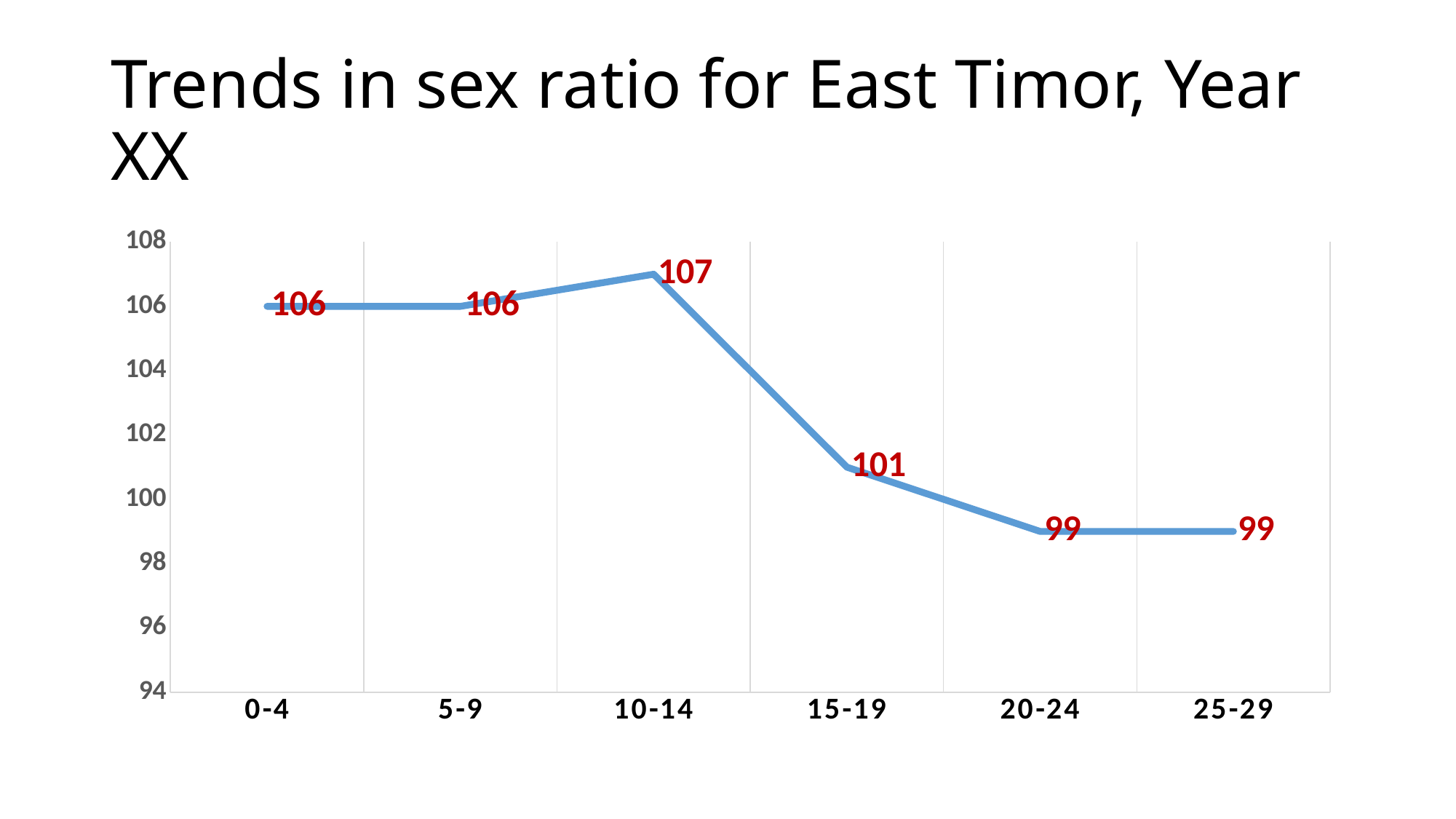
How many age groups are plotted on the chart? 6 Which is larger, the sex ratio for 5-9 or the sex ratio for 15-19? 5-9 What is the sex ratio for the 0-4 age group? 106 What is the difference between the sex ratio for 5-9 and the sex ratio for 15-19? 5 What is the sex ratio for the 10-14 age group? 107 Does the sex ratio rise or fall from the 10-14 age group to the 25-29 age group? fall Which age group has the highest sex ratio? 10-14 What is the sex ratio for the 25-29 age group? 99 What is the sex ratio for the 15-19 age group? 101 Is the sex ratio for 20-24 greater or less than 100? less What kind of chart is shown on the slide? line chart What is the difference between the sex ratio for 10-14 and the sex ratio for 20-24? 8